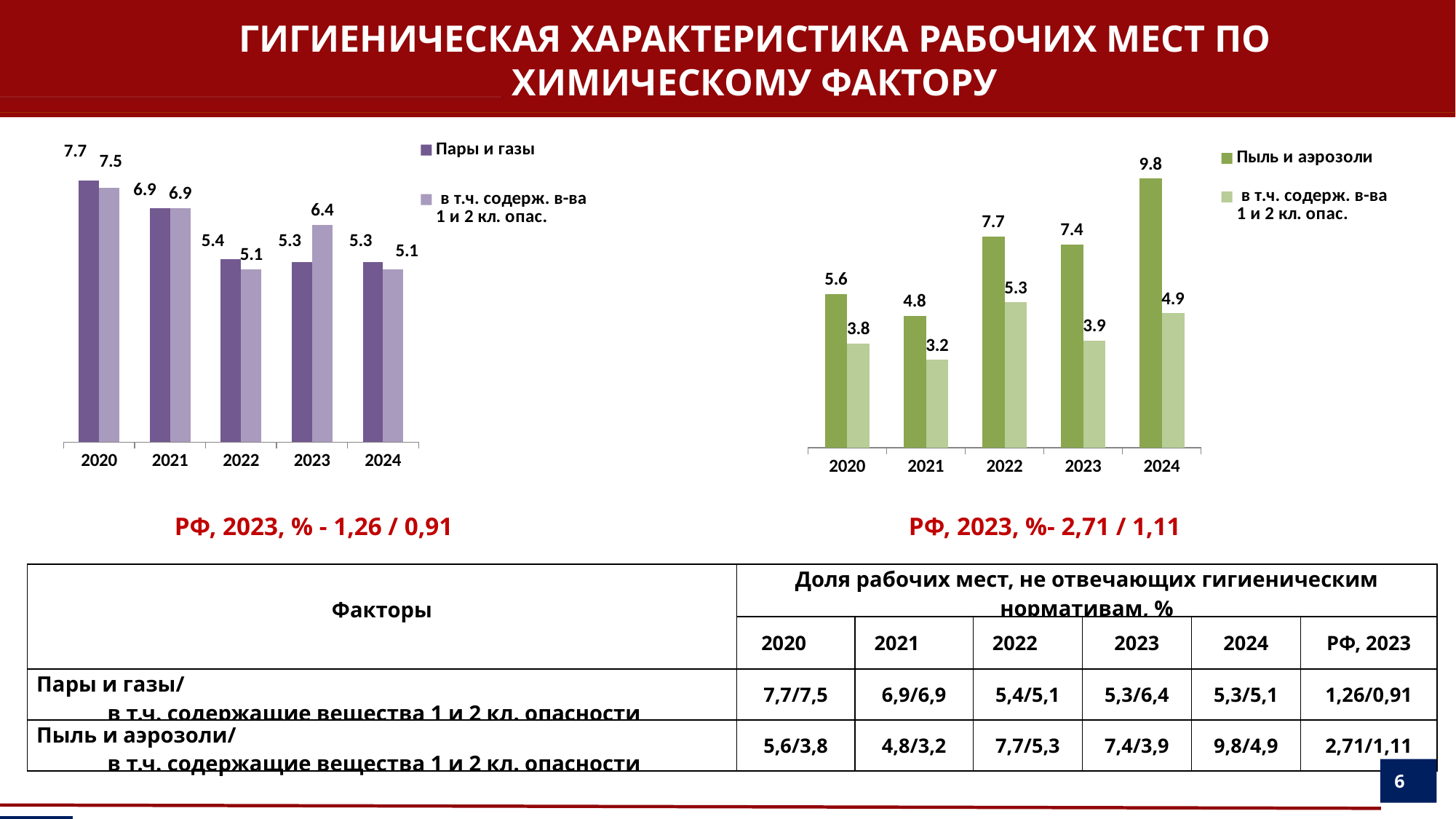
In the right chart (Пыль и аэрозоли), what is the difference between the 'Пыль и аэрозоли' value and the 'в т.ч. содерж. в-ва 1 и 2 кл. опас.' value for 2024? 4.9 What type of chart is the left chart (Пары и газы)? Bar chart How many series does the legend of the right chart (Пыль и аэрозоли) list? 2 In the left chart (Пары и газы), what is the difference between the 'Пары и газы' value for 2020 and for 2024? 2.4 In the left chart (Пары и газы), what is the value of the 'в т.ч. содерж. в-ва 1 и 2 кл. опас.' series for 2023? 6.4 In the right chart (Пыль и аэрозоли), which is larger: the 'Пыль и аэрозоли' value for 2022 or for 2023? 2022 In the right chart (Пыль и аэрозоли), what is the value of the 'в т.ч. содерж. в-ва 1 и 2 кл. опас.' series for 2021? 3.2 In the left chart (Пары и газы), which year has the highest value for the 'Пары и газы' series? 2020 In the left chart (Пары и газы), what is the value of the 'Пары и газы' series for 2020? 7.7 In the right chart (Пыль и аэрозоли), what is the value of the 'Пыль и аэрозоли' series for 2024? 9.8 In the right chart (Пыль и аэрозоли), which year has the lowest value for the 'Пыль и аэрозоли' series? 2021 In the left chart (Пары и газы), how many years are shown on the x axis? 5